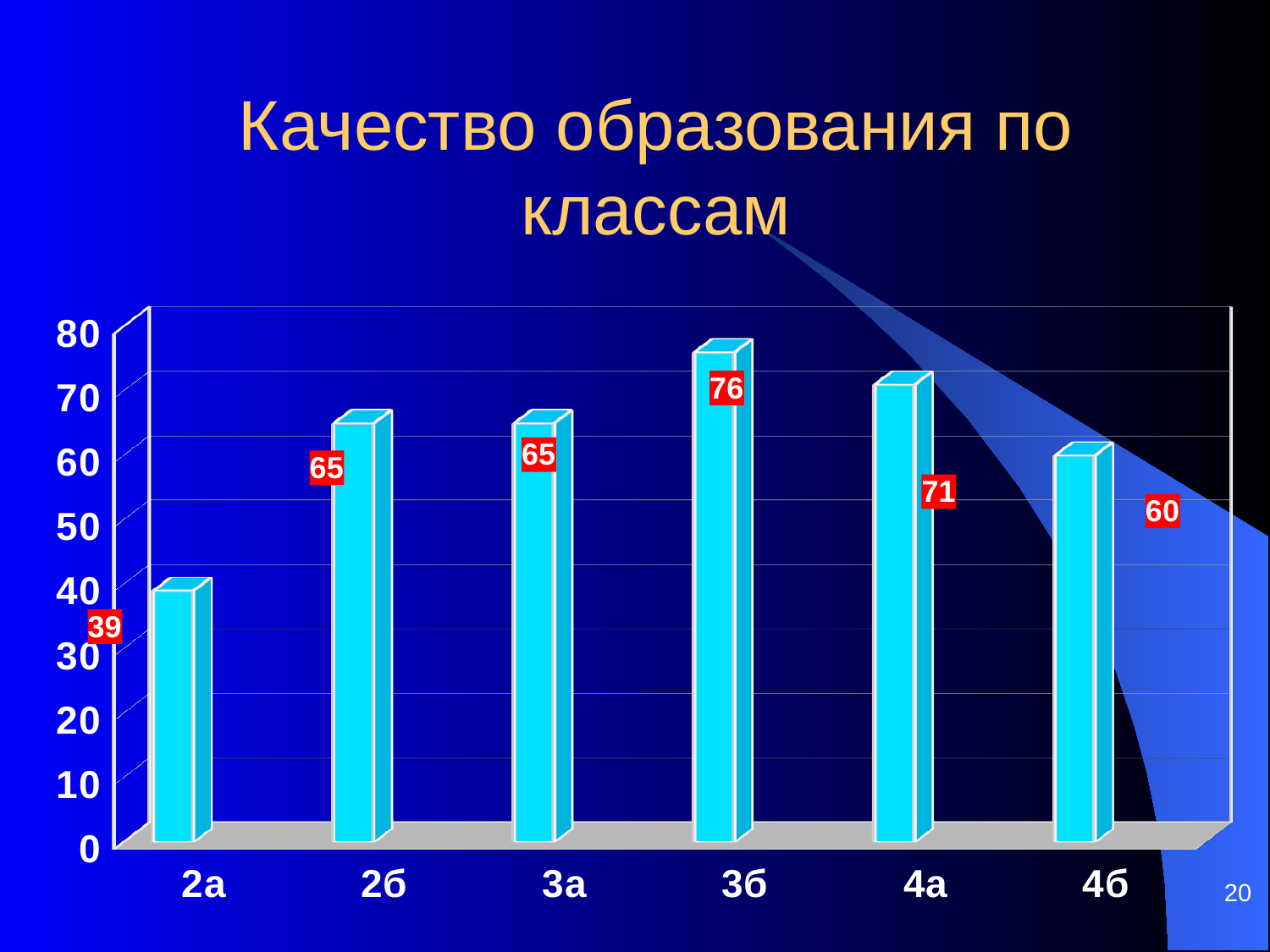
What is the value for class 4б? 60 What kind of chart is shown on the slide? bar chart What is the value for class 2а? 39 Is the value for 2б greater or less than 50? greater Which class has the highest value? 3б Which class has the lowest value? 2а Which is larger, the value for 4а or the value for 4б? 4а What is the value for class 3б? 76 What is the value for class 4а? 71 How many classes are shown on the chart? 6 What is the title of the chart? Качество образования по классам What is the difference between the values for 3б and 2а? 37